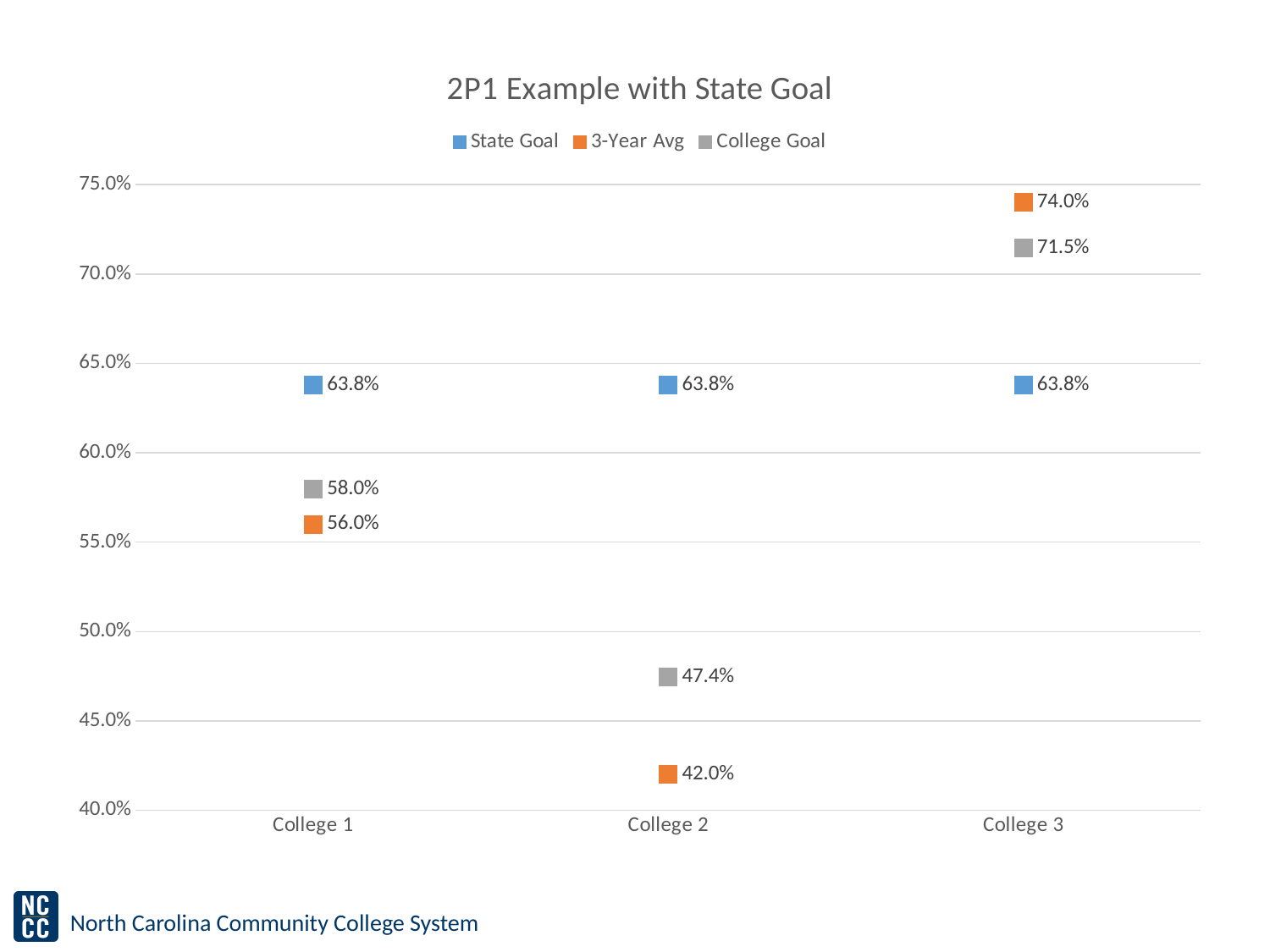
What is the difference between the 3-Year Avg for College 3 and the 3-Year Avg for College 2? 32.0% What is the College Goal value for College 1? 58.0% What is the State Goal value for College 1? 63.8% Which college has the highest 3-Year Avg? College 3 How many series does the legend list? 3 Which is larger for College 3, the 3-Year Avg or the College Goal? 3-Year Avg How many colleges are shown on the x axis? 3 What is the title of the chart? 2P1 Example with State Goal Which college has the lowest College Goal? College 2 What is the difference between the College Goal and the 3-Year Avg for College 1? 2.0% What is the College Goal value for College 3? 71.5% What is the 3-Year Avg value for College 2? 42.0%